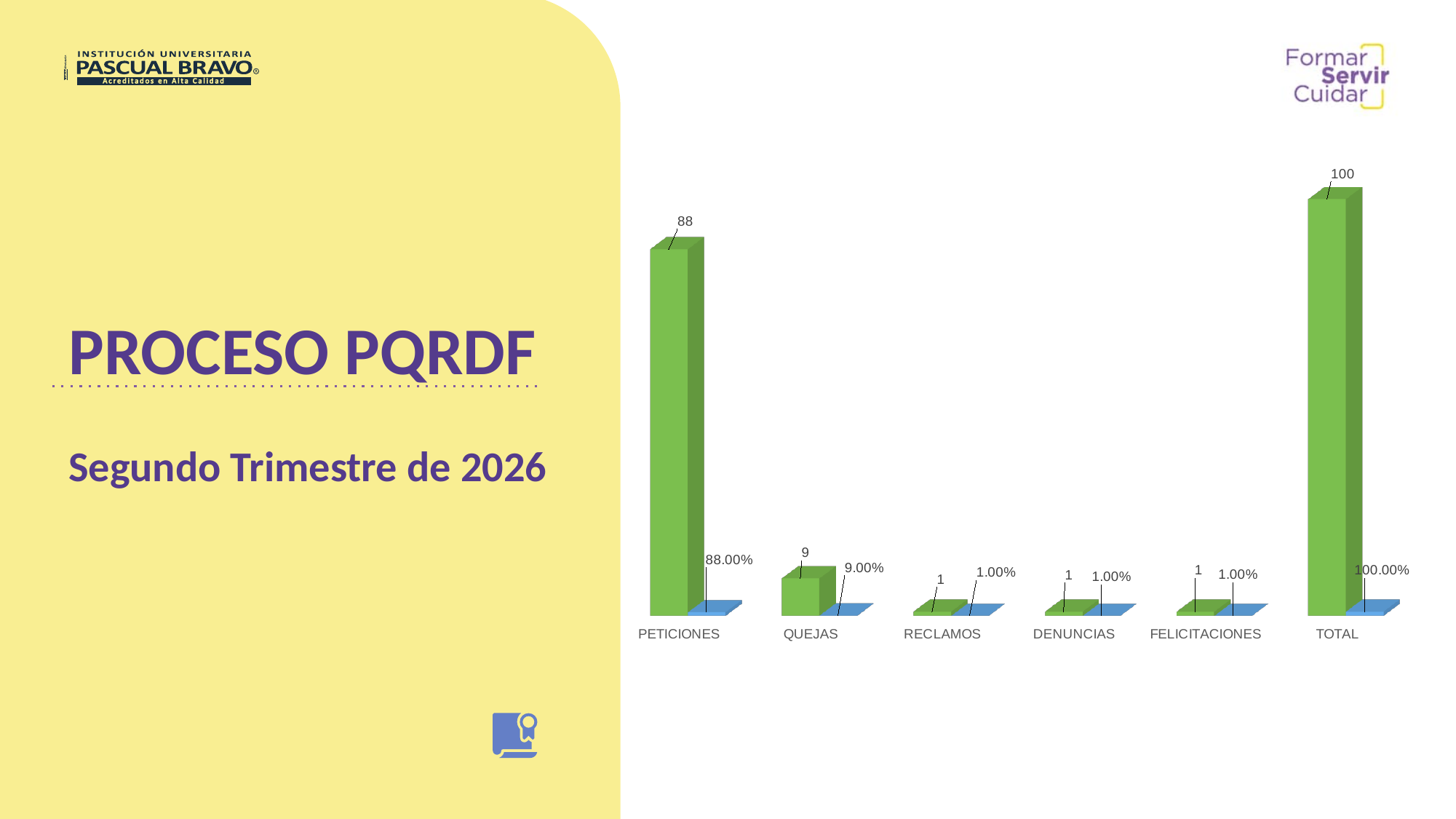
Which has a larger count, QUEJAS or RECLAMOS? QUEJAS How many categories are shown on the x axis of the chart? 6 What percentage is shown for QUEJAS? 9.00% What is the difference between the counts for PETICIONES and QUEJAS? 79 What kind of chart is shown on the slide? Bar chart What colour are the bars showing the percentage values? Blue What is the count shown for QUEJAS? 9 What percentage is shown for PETICIONES? 88.00% What is the count shown for DENUNCIAS? 1 What is the count shown for PETICIONES? 88 What is the count shown for TOTAL? 100 Excluding TOTAL, which category has the highest count? PETICIONES